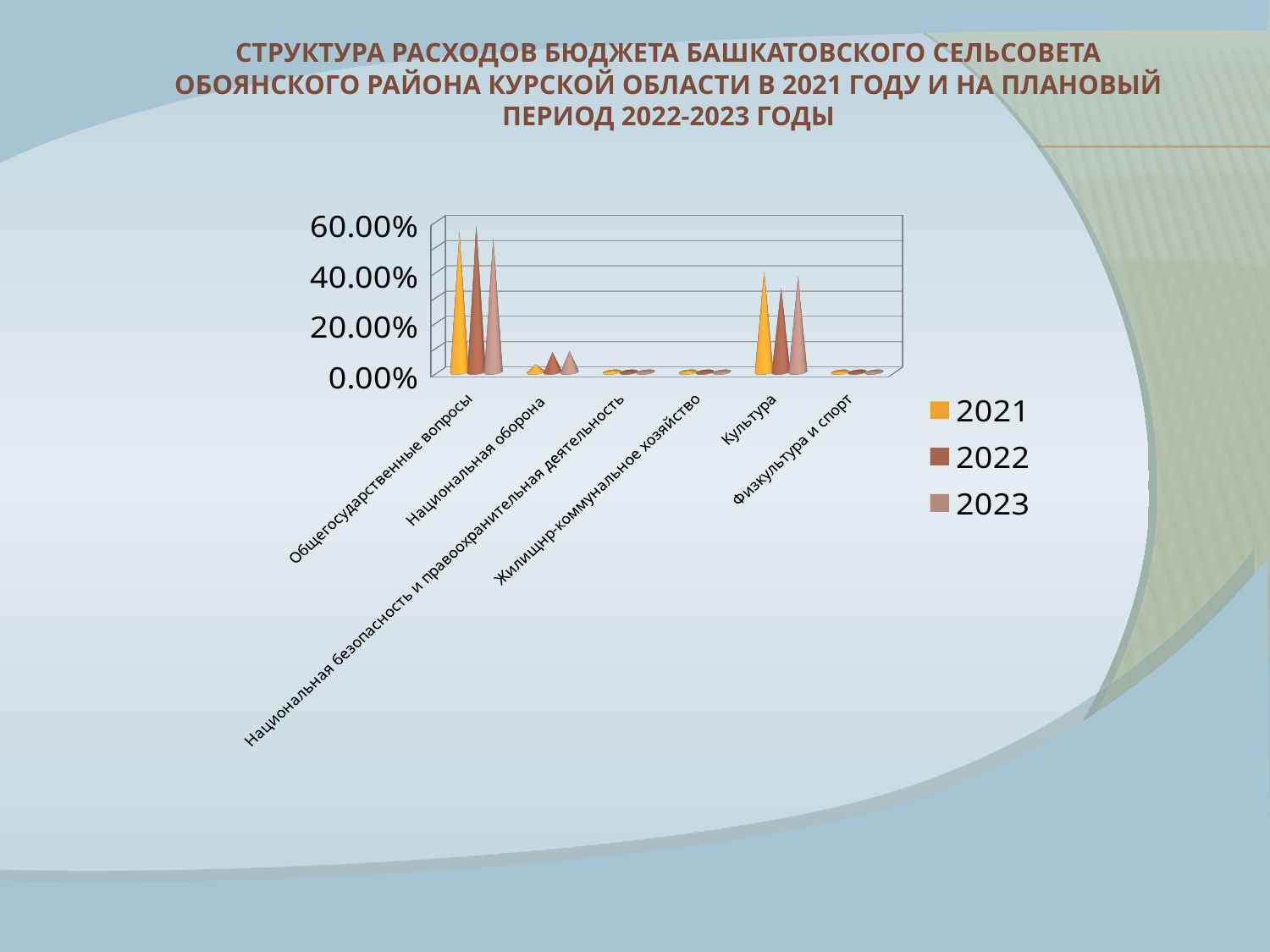
Is the 2021 value for Общегосударственные вопросы greater or less than 40%? greater For the 2023 series, which is larger: Культура or Национальная оборона? Культура How many categories are shown on the x axis of the chart? 6 Which category has the highest value for the 2021 series? Общегосударственные вопросы Which series are listed in the chart legend? 2021, 2022, 2023 Which category has the highest value for the 2023 series? Общегосударственные вопросы Is the 2022 value for Национальная оборона greater or less than 20%? less Is the 2021 value for Культура greater or less than 20%? greater How many series does the chart legend list? 3 For the 2022 series, which is larger: Общегосударственные вопросы or Культура? Общегосударственные вопросы What kind of chart is shown on the slide? Bar chart